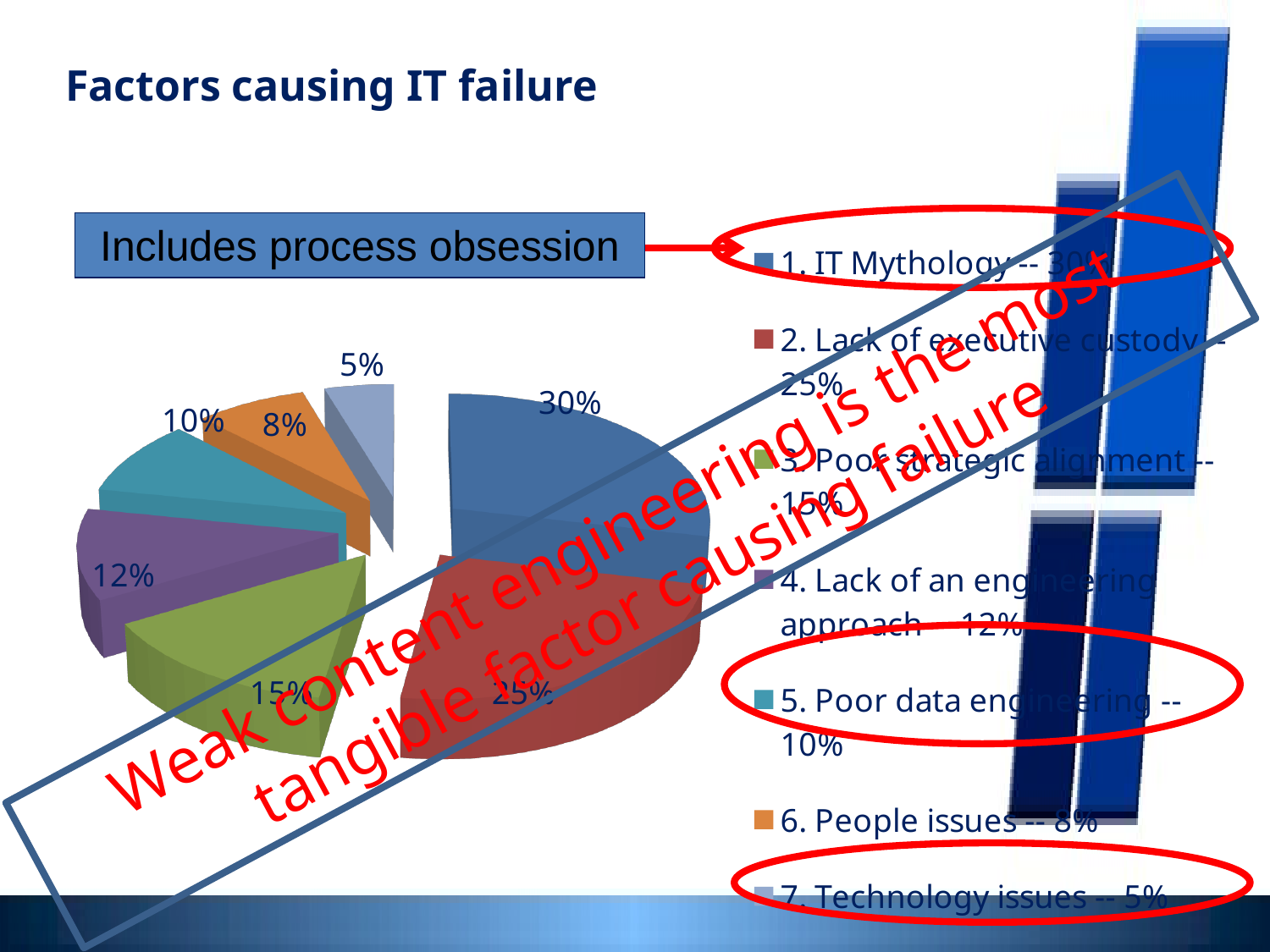
How many slices does the pie chart have? 7 What is the title of the chart on the slide? Factors causing IT failure Which factor has the largest slice of the pie? IT Mythology What share of the pie is IT Mythology? 30% What share of the pie is Lack of an engineering approach? 12% What share of the pie is Technology issues? 5% What is the difference between the shares for IT Mythology and Lack of executive custody? 5% What kind of chart is shown on the slide? Pie chart Which is larger, the share for Poor strategic alignment or the share for People issues? Poor strategic alignment Which factor has the smallest slice of the pie? Technology issues